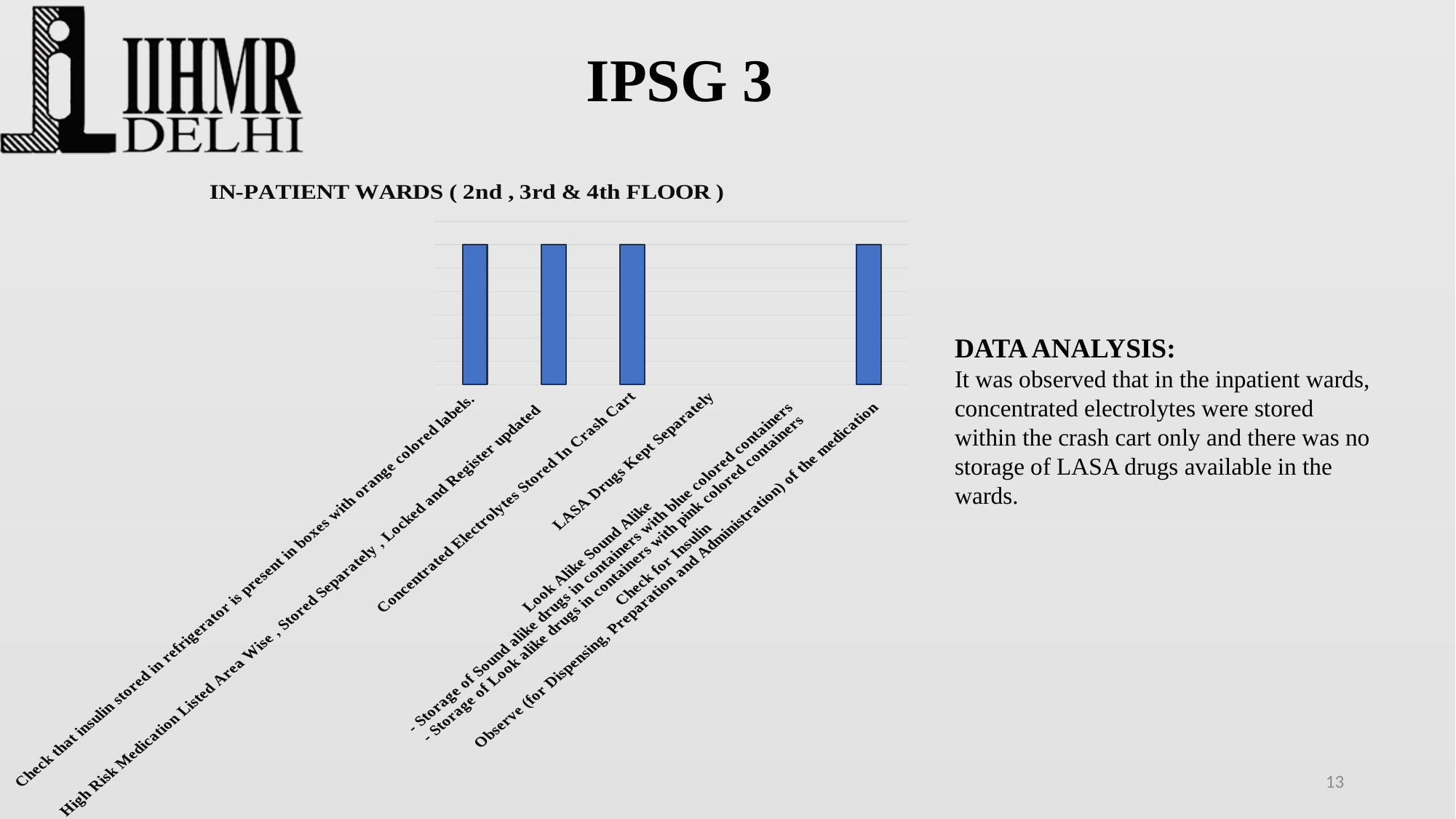
What colour are the bars in the chart? Blue How many categories in the chart have a visible bar? 4 Which is larger in the chart: the value for "Concentrated Electrolytes Stored In Crash Cart" or the value for "LASA Drugs Kept Separately"? Concentrated Electrolytes Stored In Crash Cart What is the title of the chart? IN-PATIENT WARDS ( 2nd , 3rd & 4th FLOOR ) Which is larger in the chart: the value for "Check that insulin stored in refrigerator is present in boxes with orange colored labels." or the value for "Look Alike Sound Alike - Storage of Sound alike drugs in containers with blue colored containers"? Check that insulin stored in refrigerator is present in boxes with orange colored labels. How many categories are shown along the x axis of the chart? 6 What kind of chart is shown on the slide? Bar chart Does the category "LASA Drugs Kept Separately" have a visible bar in the chart? No